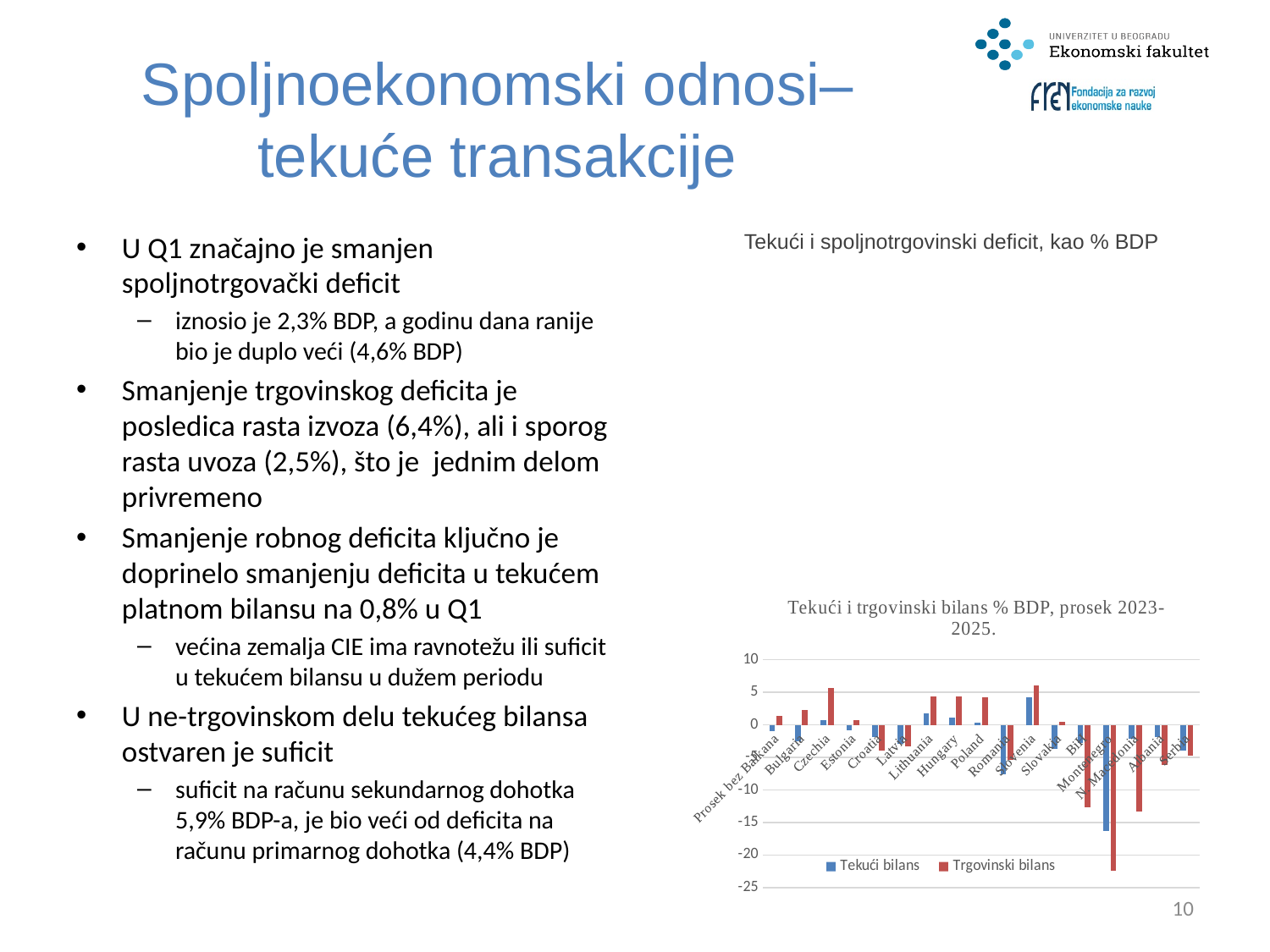
Which category has the lowest Tekući bilans value in the chart? Montenegro How many series does the legend of the chart list? 2 Which is larger, the Tekući bilans value for Slovenia or for Bulgaria? Slovenia How many countries/categories are shown on the x axis of the chart? 17 Is the Tekući bilans value for Montenegro greater or less than -10? less Is the Trgovinski bilans value for Montenegro greater or less than -20? less Is the Trgovinski bilans value for BiH greater or less than -10? less What colour are the Trgovinski bilans bars in the chart? red What are the two series named in the chart legend? Tekući bilans and Trgovinski bilans What kind of chart is shown on the slide? bar chart Which category has the lowest Trgovinski bilans value in the chart? Montenegro Which category has the highest Tekući bilans value in the chart? Slovenia